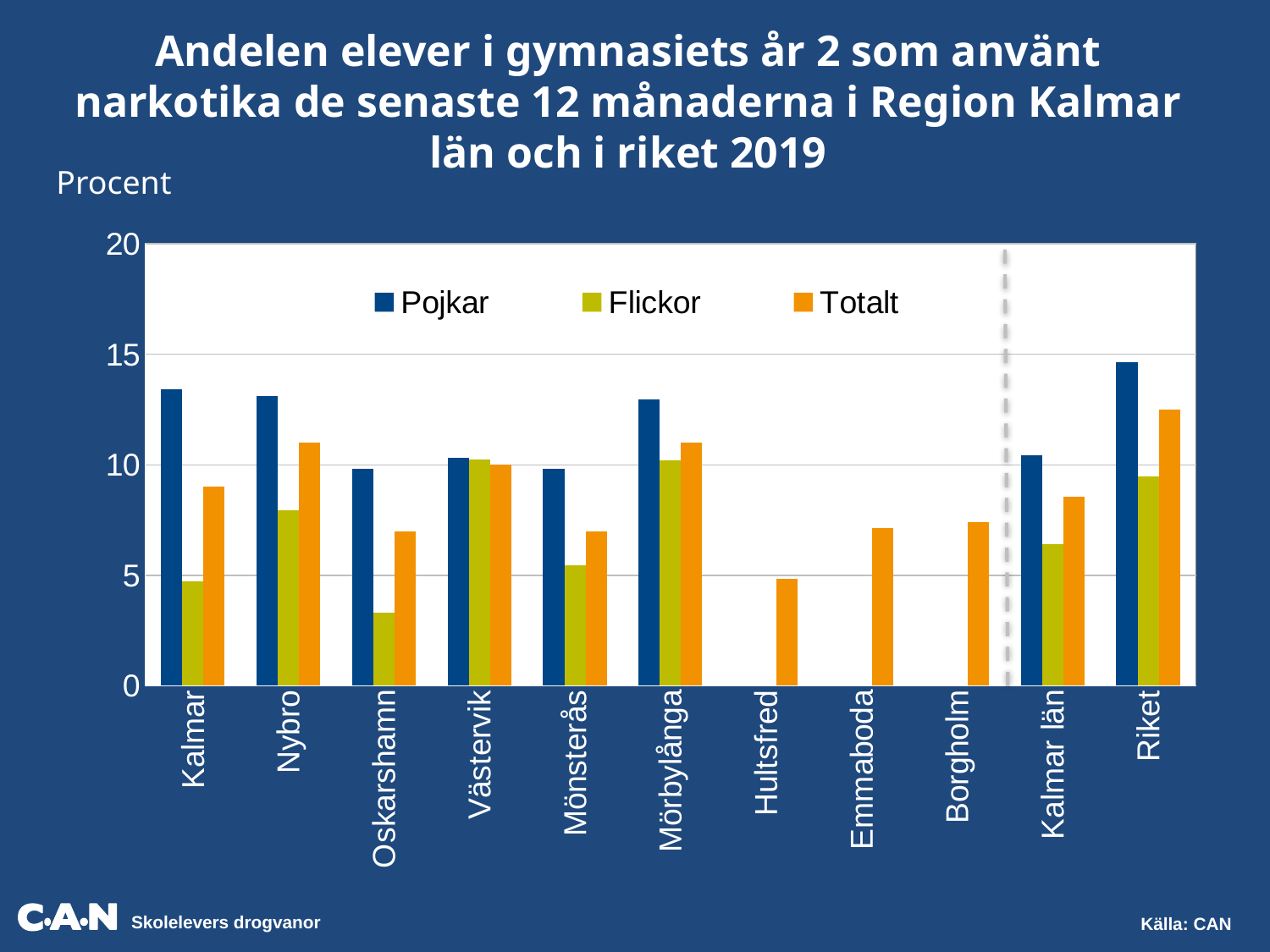
What kind of chart is shown on the slide? bar chart Which category has the highest value for Totalt? Riket Is the value for Totalt in Emmaboda greater or less than 5? greater Which is larger in Kalmar, the value for Pojkar or the value for Flickor? Pojkar What label is shown on the y axis of the chart? Procent Which category has the highest value for Pojkar? Riket Is the value for Pojkar in Kalmar greater or less than 10? greater Which category has the lowest value for Totalt? Hultsfred How many series does the legend list? 3 Is the value for Flickor in Oskarshamn greater or less than 5? less How many categories are shown along the x axis? 11 Which category has the lowest value for Flickor among those with a Flickor bar? Oskarshamn